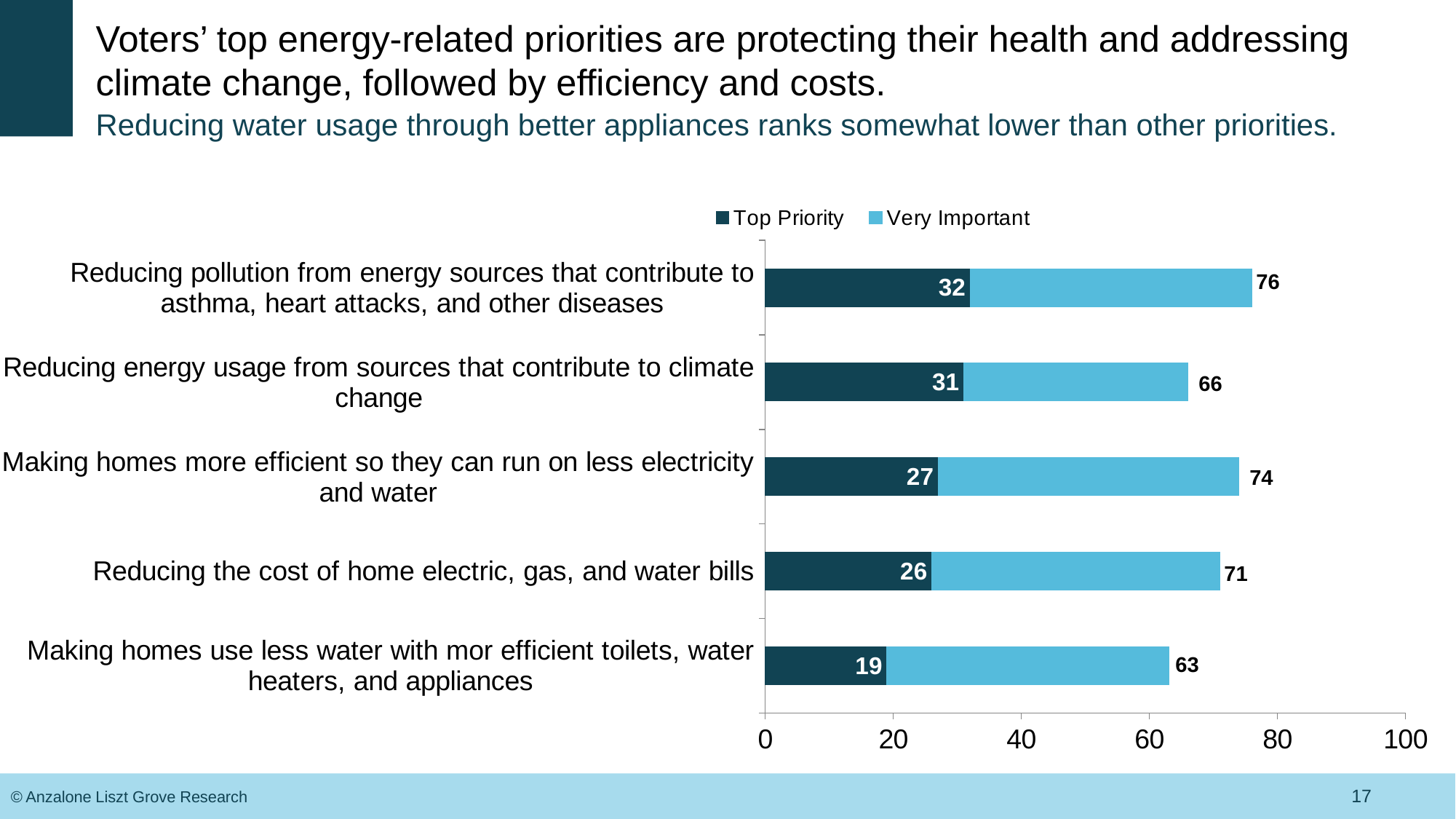
How many priority categories are plotted in the chart? 5 What type of chart is shown on the slide? Stacked bar chart What is the difference between the combined totals for 'Reducing pollution from energy sources that contribute to asthma, heart attacks, and other diseases' and 'Reducing energy usage from sources that contribute to climate change'? 10 How many series does the legend list? 2 What is the total (Top Priority plus Very Important) for 'Reducing the cost of home electric, gas, and water bills'? 71 Which legend entry is shown in the darker colour? Top Priority What is the Top Priority value for 'Making homes use less water with mor efficient toilets, water heaters, and appliances'? 19 What is the Top Priority value for 'Reducing pollution from energy sources that contribute to asthma, heart attacks, and other diseases'? 32 Which category has the highest combined total? Reducing pollution from energy sources that contribute to asthma, heart attacks, and other diseases What is the total (Top Priority plus Very Important) for 'Making homes more efficient so they can run on less electricity and water'? 74 Which category has the lowest Top Priority value? Making homes use less water with mor efficient toilets, water heaters, and appliances Which has a larger combined total: 'Reducing energy usage from sources that contribute to climate change' or 'Reducing the cost of home electric, gas, and water bills'? Reducing the cost of home electric, gas, and water bills